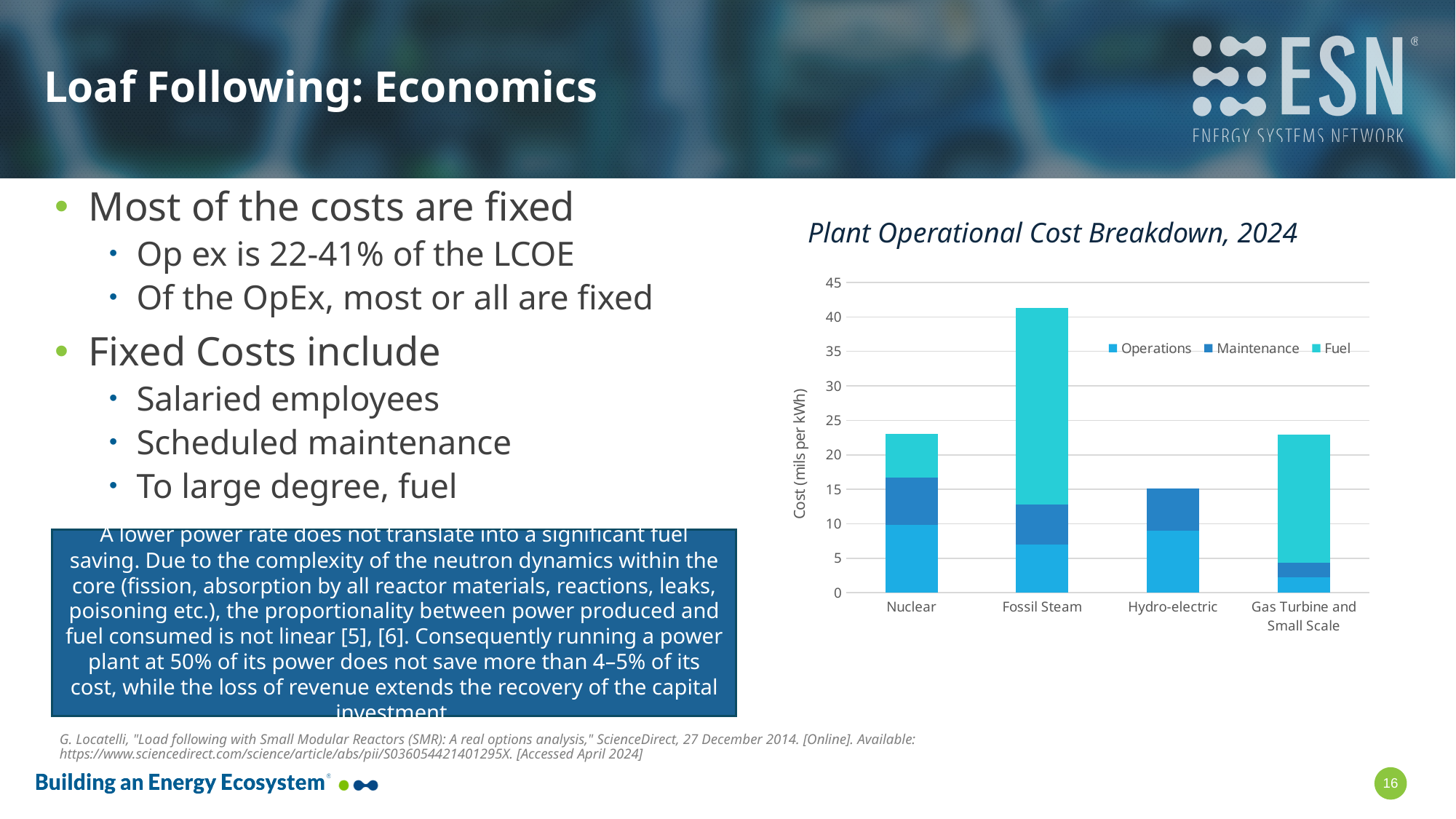
Which has a larger total cost, Nuclear or Hydro-electric? Nuclear Which plant category has the lowest total cost in the chart? Hydro-electric How many series does the chart legend list? 3 How many plant categories are shown on the x axis of the chart? 4 Is the total cost for Fossil Steam greater or less than 35 mils per kWh? greater What kind of chart is shown on the slide? Stacked bar chart Which plant category has the highest total cost in the chart? Fossil Steam Which has a larger total cost, Fossil Steam or Hydro-electric? Fossil Steam Is the total cost for Hydro-electric greater or less than 20 mils per kWh? less Is the Operations cost for Gas Turbine and Small Scale greater or less than 5 mils per kWh? less What is the label of the y axis of the chart? Cost (mils per kWh) What is the title of the chart? Plant Operational Cost Breakdown, 2024